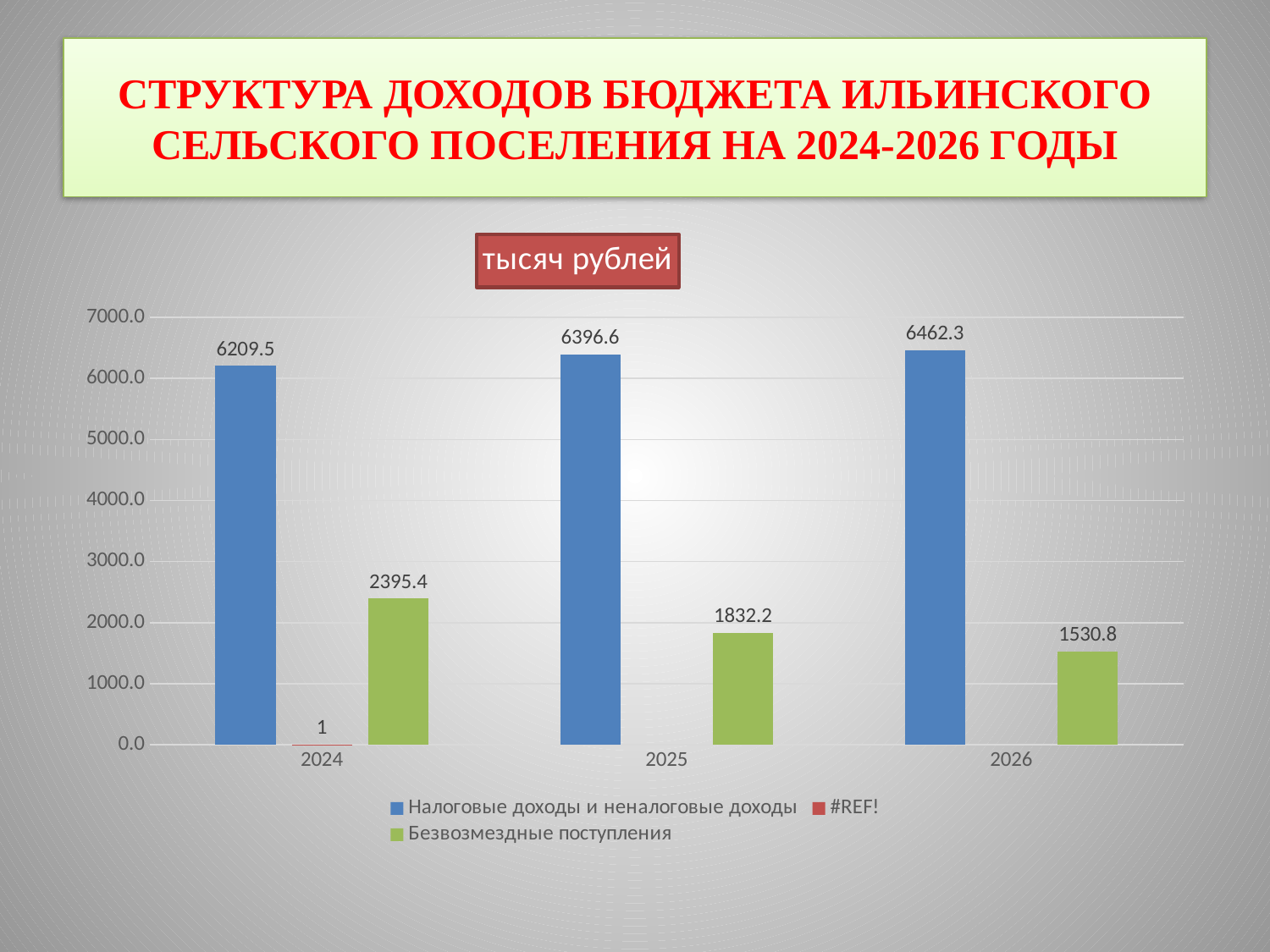
What is the value of Безвозмездные поступления for 2026? 1530.8 What kind of chart is shown on the slide? bar chart How many series does the legend list? 3 What is the value of Безвозмездные поступления for 2024? 2395.4 Do the values of Безвозмездные поступления rise or fall from 2024 to 2026? fall How many years are shown on the x axis? 3 In which year is Безвозмездные поступления lowest? 2026 Which is larger in 2025: Налоговые доходы и неналоговые доходы or Безвозмездные поступления? Налоговые доходы и неналоговые доходы What is the difference between Безвозмездные поступления in 2024 and in 2025? 563.2 What is the difference between Налоговые доходы и неналоговые доходы in 2026 and in 2024? 252.8 In which year is Налоговые доходы и неналоговые доходы highest? 2026 What is the value of Налоговые доходы и неналоговые доходы for 2025? 6396.6